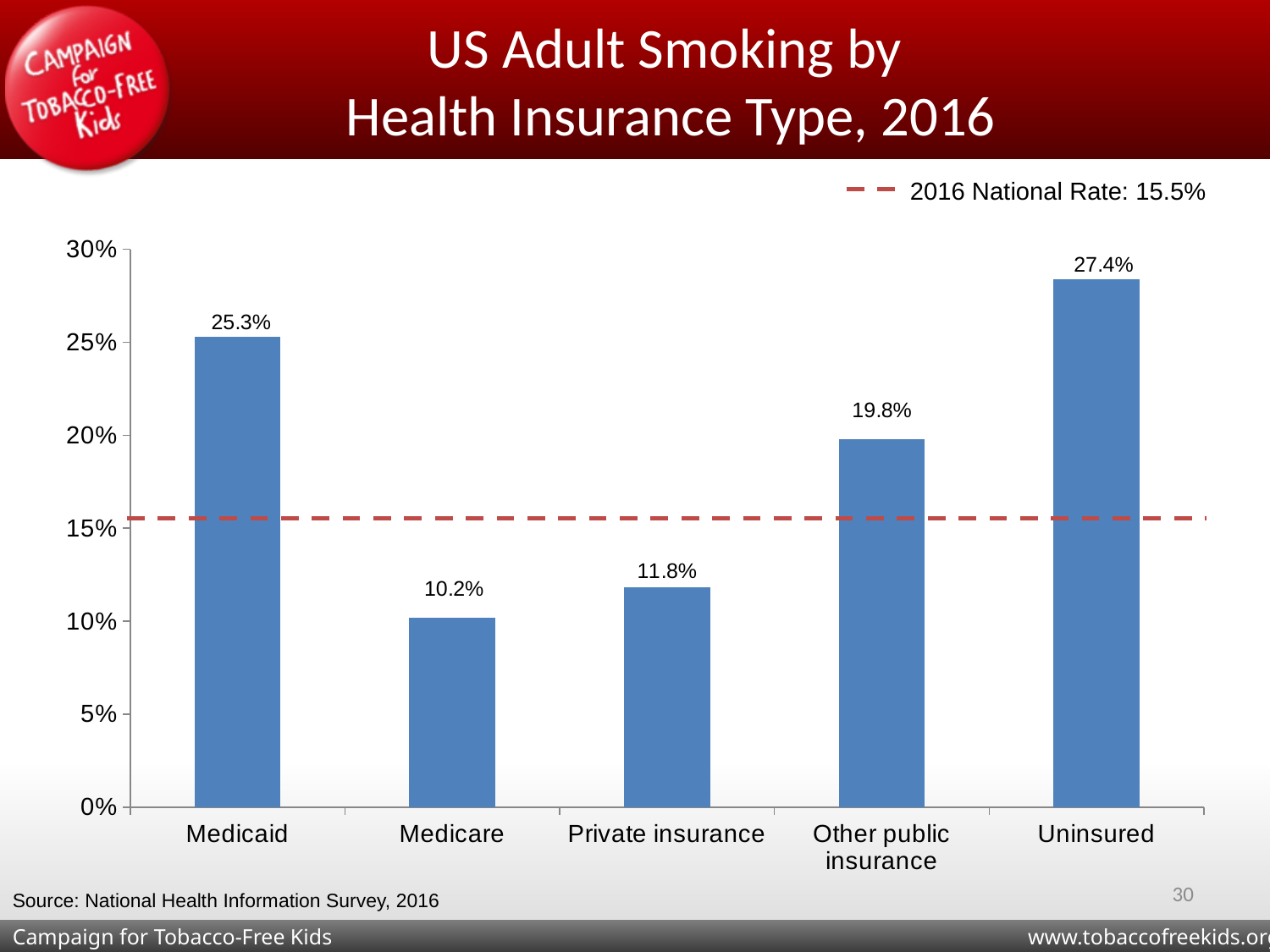
What is the 2016 National Rate shown by the dashed line? 15.5% What is the adult smoking rate for Medicare? 10.2% How many health insurance types are shown on the chart? 5 What is the adult smoking rate for Medicaid? 25.3% What kind of chart is shown on the slide? Bar chart What is the adult smoking rate for Other public insurance? 19.8% What is the adult smoking rate for Private insurance? 11.8% What is the difference between the smoking rates for Uninsured and Medicaid? 2.1% Which health insurance type has the lowest adult smoking rate? Medicare Which health insurance type has the highest adult smoking rate? Uninsured Is the value for Private insurance greater or less than 15%? less Which has a higher smoking rate, Medicaid or Other public insurance? Medicaid